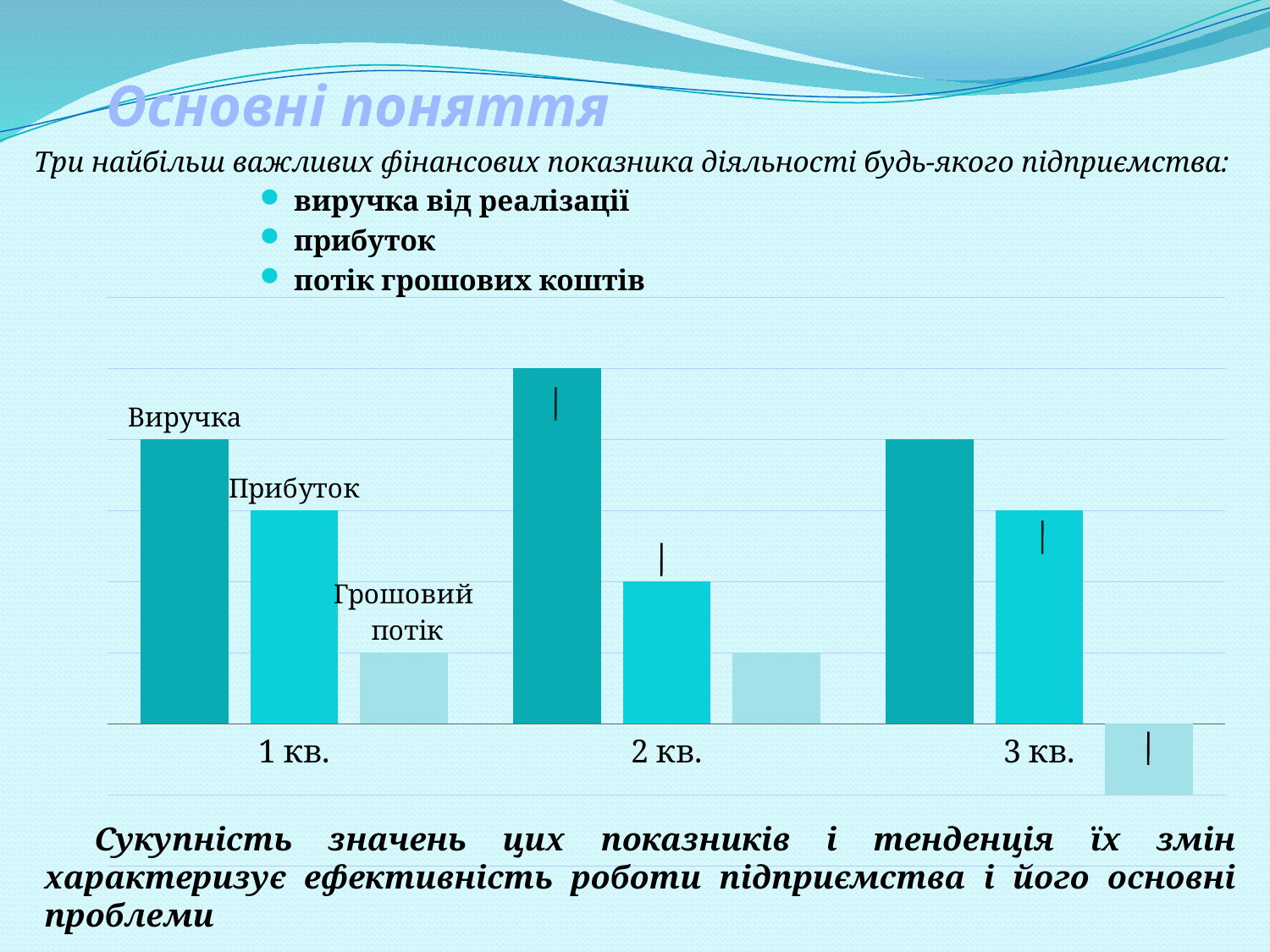
In which quarter is Грошовий потік lowest? 3 кв. What are the three series labels shown on the chart? Виручка, Прибуток, Грошовий потік In which quarter is Виручка highest? 2 кв. What kind of chart is shown on the slide? bar chart Does Прибуток rise or fall from 1 кв. to 2 кв.? fall Is the Грошовий потік bar for 3 кв. above or below the horizontal axis? below How many indicators (series) are plotted in the chart? 3 How many quarters (categories) are shown on the x axis of the chart? 3 In which quarter is Прибуток lowest? 2 кв. In 2 кв., which indicator has the tallest bar? Виручка In 1 кв., which indicator has the shortest bar? Грошовий потік In 1 кв., which is larger: Виручка or Прибуток? Виручка